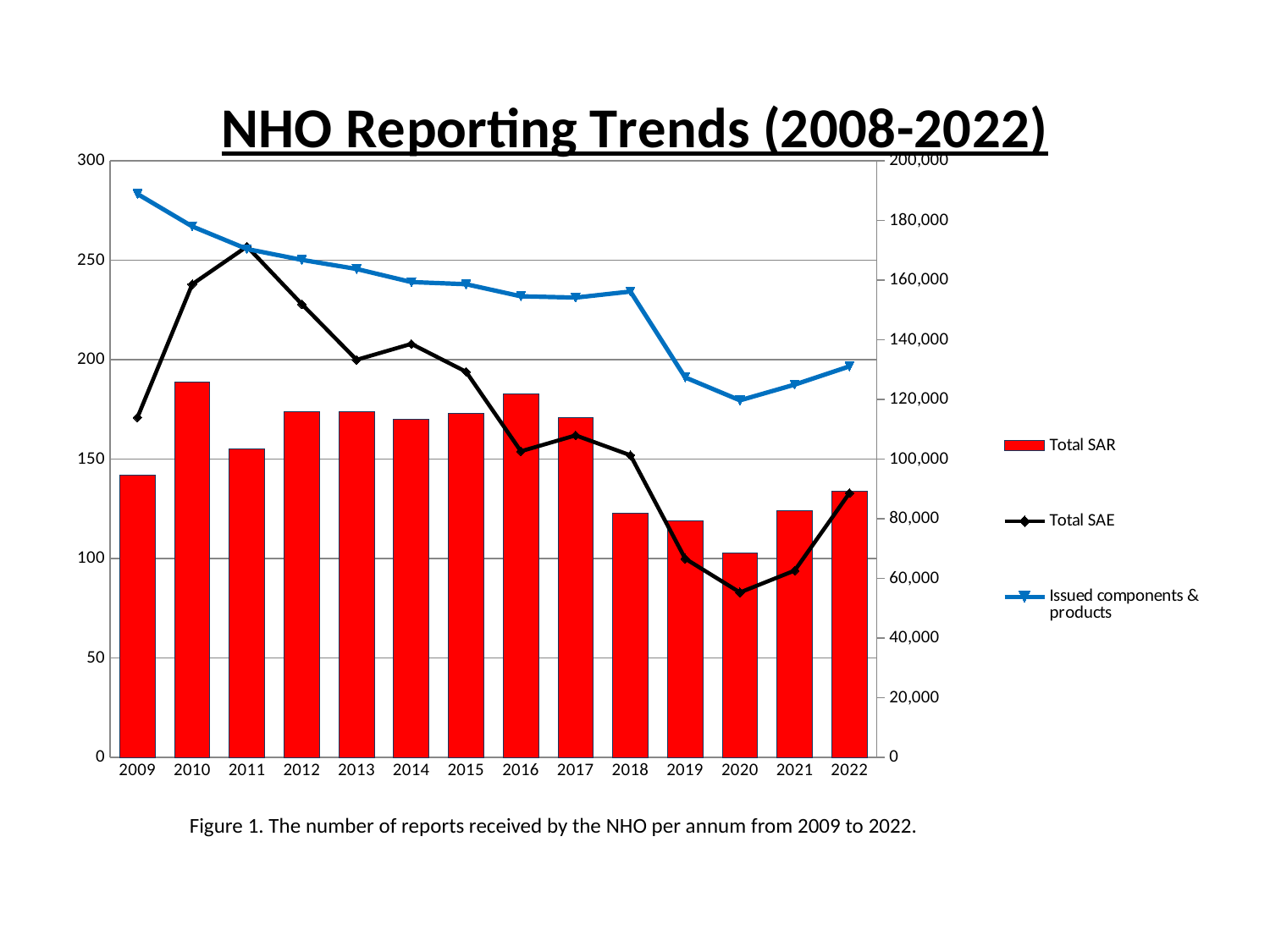
How many series does the legend list? 3 In which year is the Total SAR bar highest? 2010 What is the title of the chart? NHO Reporting Trends (2008-2022) In which year does the Issued components & products line reach its lowest point? 2020 Is the Total SAR value for 2020 greater or less than 150? less Which year has the larger Total SAR value, 2010 or 2019? 2010 In which year does the Total SAE line reach its highest point? 2011 Which series is plotted as red bars? Total SAR Is the Issued components & products value for 2009 greater or less than 180,000? greater In which year is the Total SAR bar lowest? 2020 How many years are shown on the x axis of the chart? 14 Does the Issued components & products line generally rise or fall from 2009 to 2022? fall